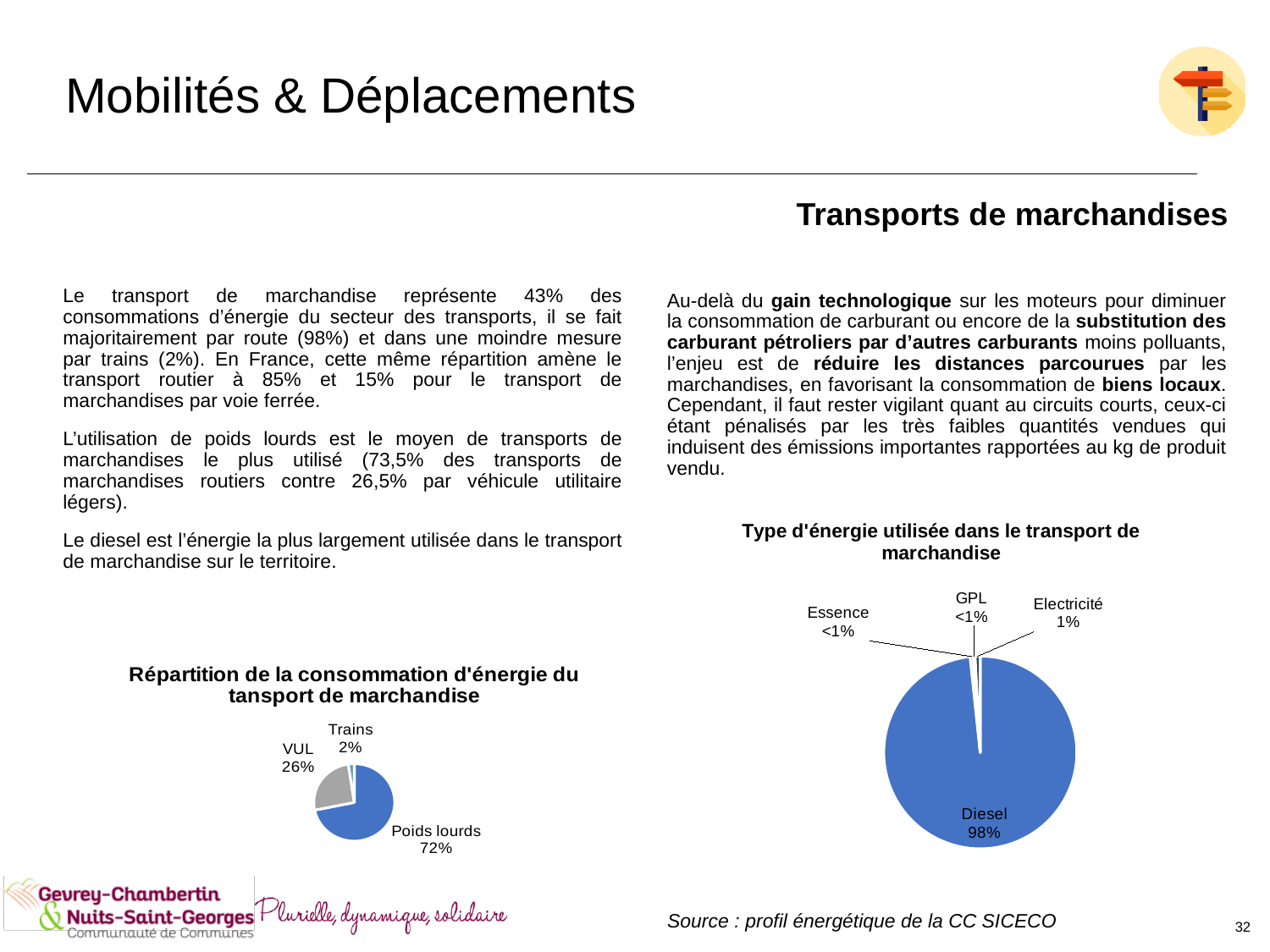
In the 'Type d'énergie utilisée dans le transport de marchandise' chart, what share is shown for Electricité? 1% In the 'Type d'énergie utilisée dans le transport de marchandise' chart, what share is shown for Diesel? 98% In the 'Répartition de la consommation d'énergie du tansport de marchandise' chart, how many slices does the pie have? 3 In the 'Répartition de la consommation d'énergie du tansport de marchandise' chart, what share is shown for VUL? 26% In the 'Type d'énergie utilisée dans le transport de marchandise' chart, which category has the largest slice? Diesel What is the title of the pie chart on the right side of the slide? Type d'énergie utilisée dans le transport de marchandise In the 'Répartition de la consommation d'énergie du tansport de marchandise' chart, what is the difference between the Poids lourds share and the VUL share? 46% What kind of chart is the 'Répartition de la consommation d'énergie du tansport de marchandise' chart? pie chart In the 'Type d'énergie utilisée dans le transport de marchandise' chart, how many categories are labelled? 4 In the 'Répartition de la consommation d'énergie du tansport de marchandise' chart, which category has the smallest slice? Trains In the 'Répartition de la consommation d'énergie du tansport de marchandise' chart, what share is shown for Poids lourds? 72% In the 'Type d'énergie utilisée dans le transport de marchandise' chart, what share is shown for GPL? <1%